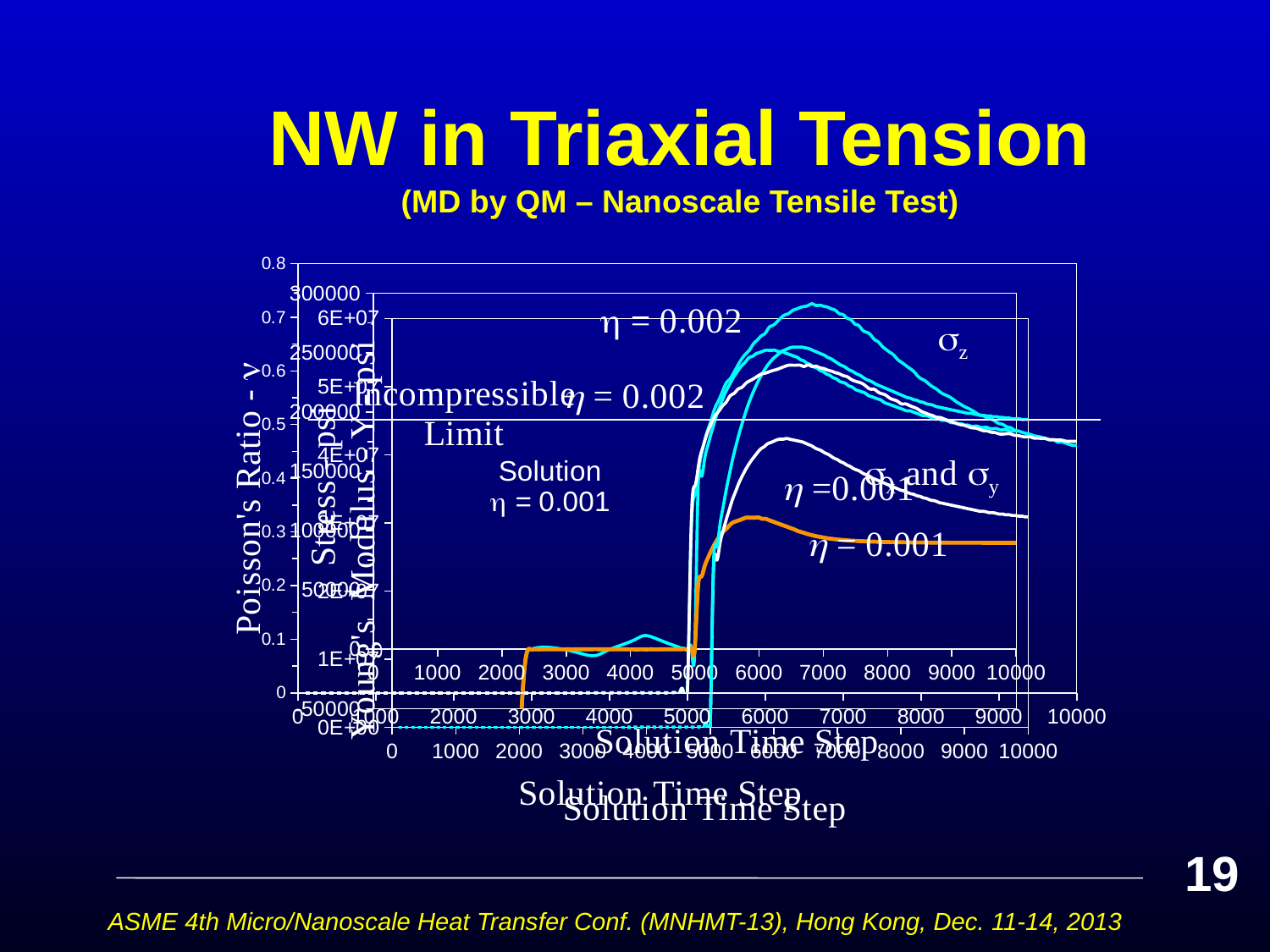
At what Poisson's ratio value is the horizontal 'Incompressible Limit' line drawn? 0.5 What kind of chart is shown on the slide? line chart Between solution time steps 5000 and 6000, do the plotted curves rise or fall? rise What is the label of the x axis on the chart? Solution Time Step